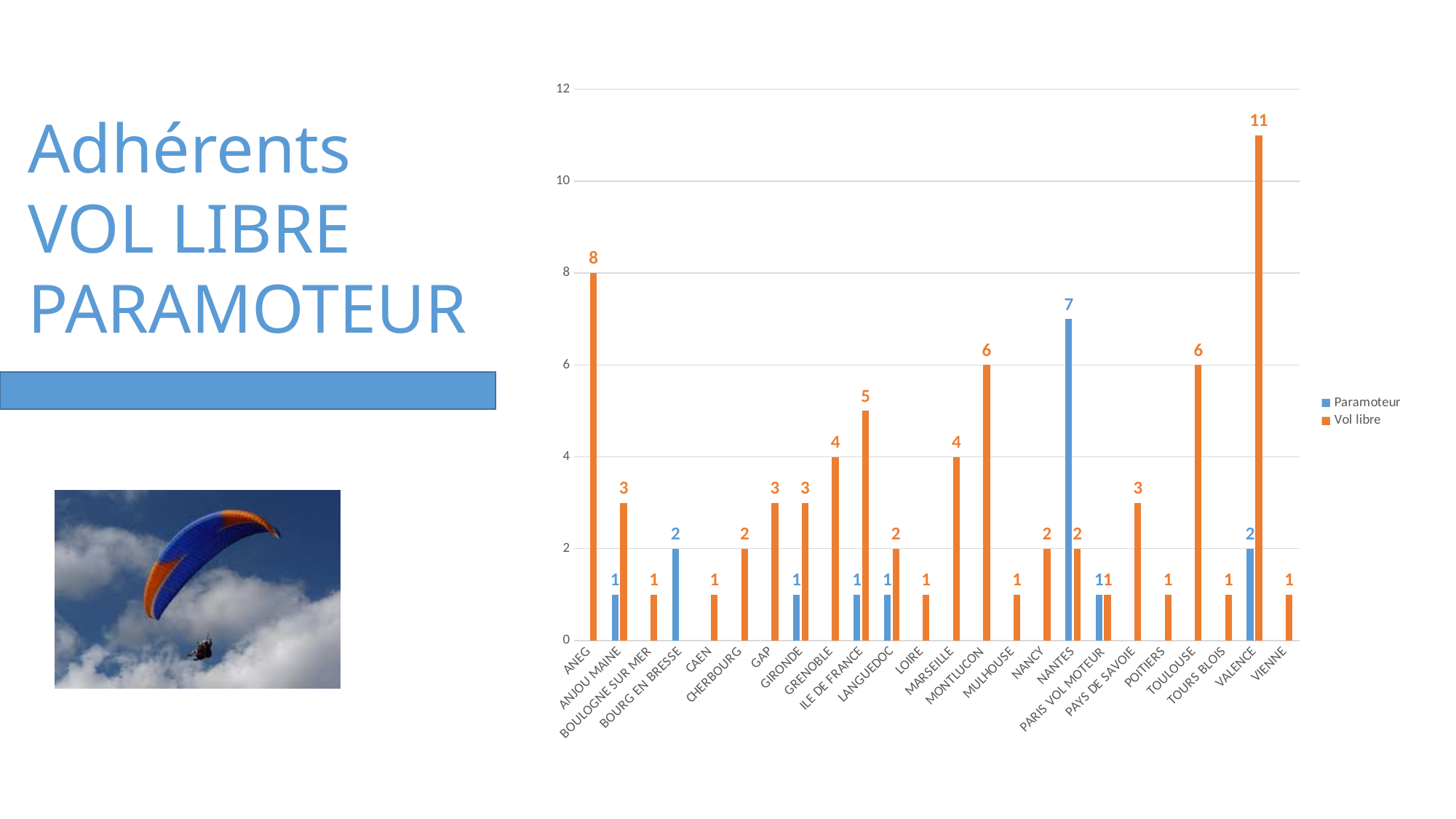
Which category has the highest Paramoteur value? NANTES What is the difference between the Vol libre values for VALENCE and ANEG? 3 What is the Paramoteur value for NANTES? 7 Which is larger, the Vol libre value for MONTLUCON or the Vol libre value for GRENOBLE? MONTLUCON What is the Vol libre value for ANEG? 8 What colour are the Vol libre bars? Orange Which category has the highest Vol libre value? VALENCE What is the Vol libre value for VALENCE? 11 How many series does the legend list? 2 How many categories are shown on the x axis? 24 What kind of chart is shown on the slide? Bar chart What is the Vol libre value for ILE DE FRANCE? 5